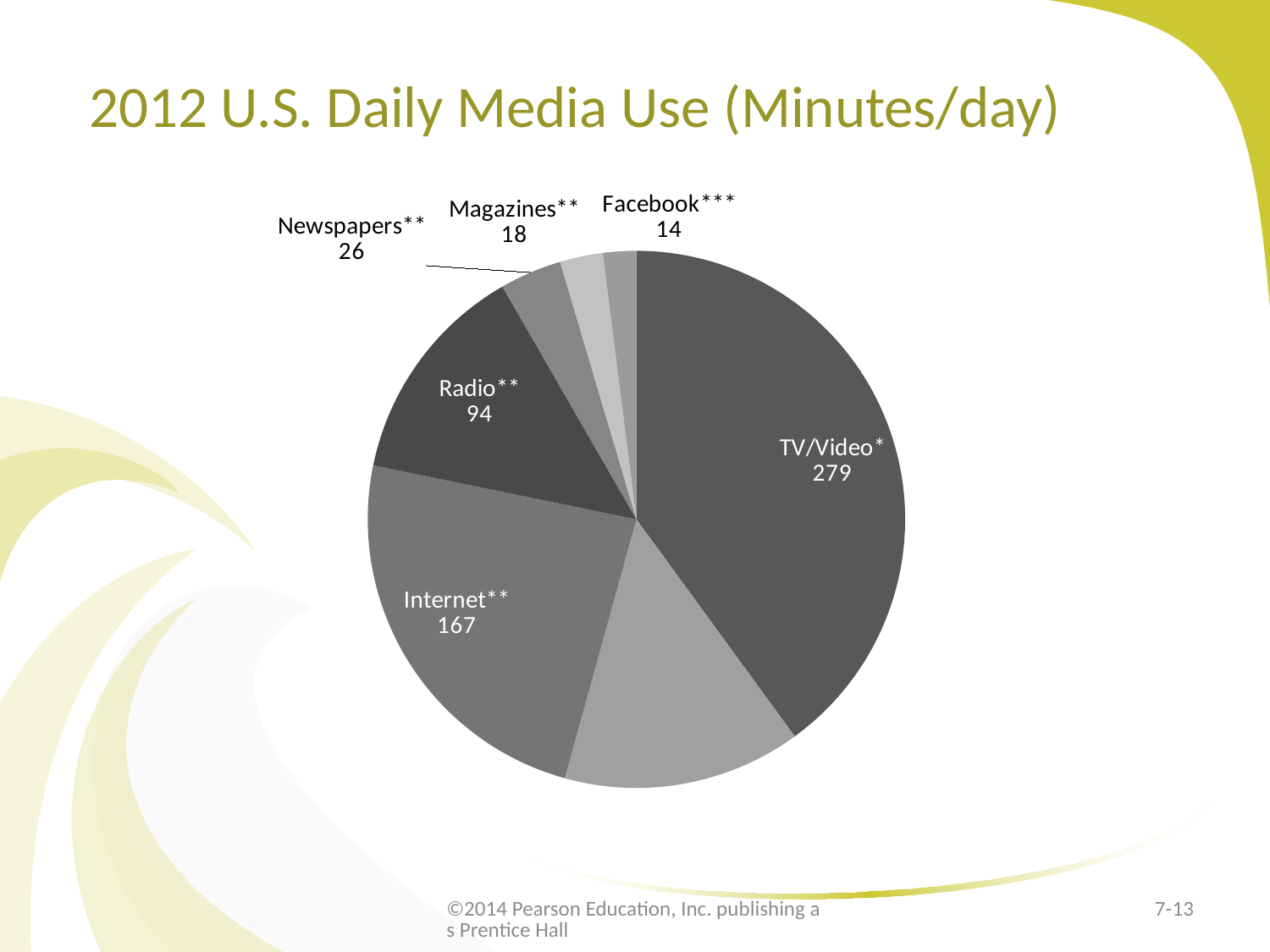
How many minutes per day are shown for Internet**? 167 Which is larger, the value for Magazines** or the value for Facebook***? Magazines** Which labeled category has the smallest slice of the pie? Facebook*** What is the difference between the Radio** value and the Newspapers** value? 68 What kind of chart is shown on the slide? Pie chart What value is shown for Facebook***? 14 What is the value for TV/Video* in the pie chart? 279 What is the title of the slide? 2012 U.S. Daily Media Use (Minutes/day) What is the difference between the TV/Video* value and the Internet** value? 112 Which category has the largest slice of the pie? TV/Video* What value is shown for Radio**? 94 What is the value labeled for Newspapers**? 26